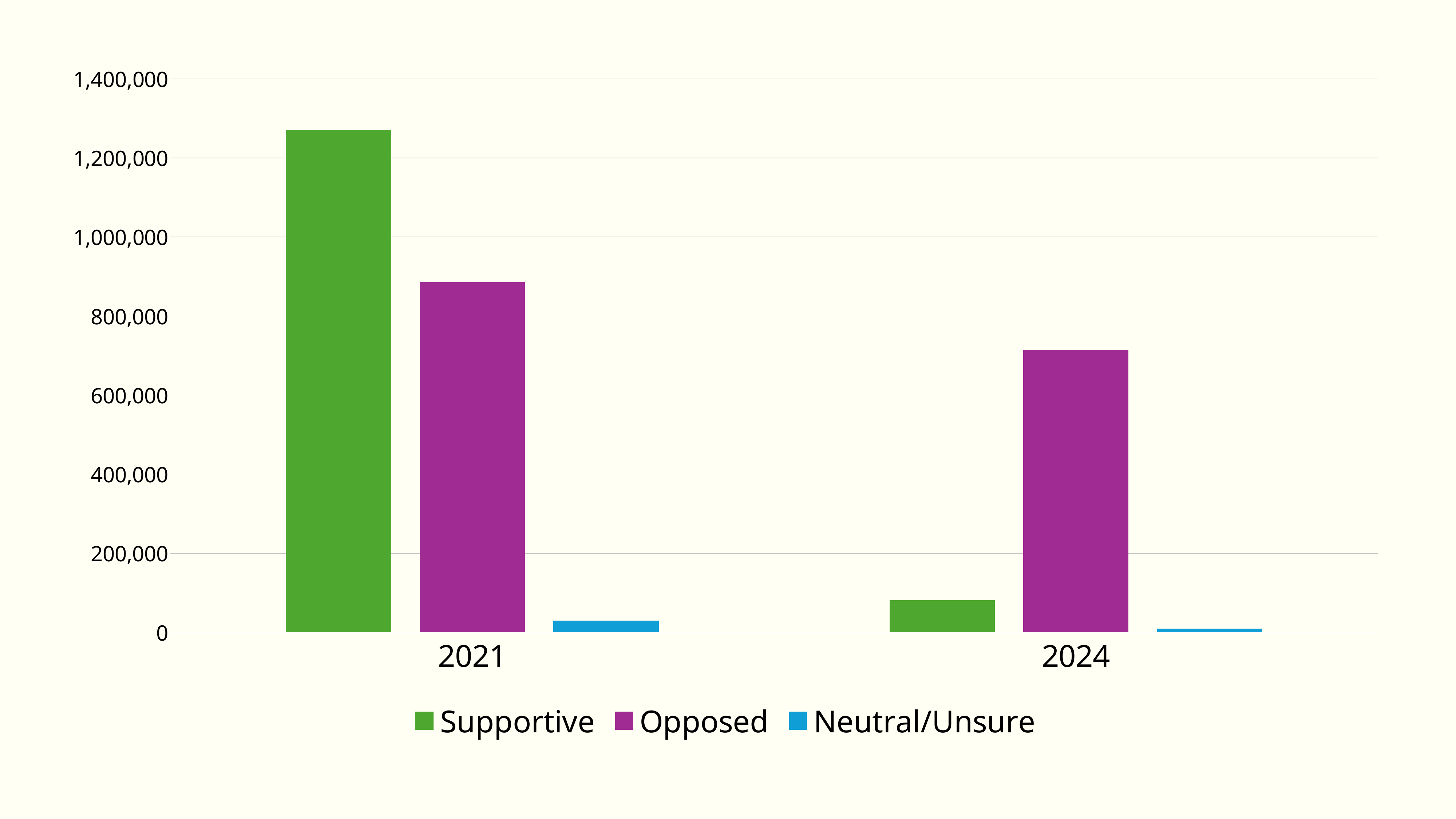
Is the value for Opposed in 2024 greater or less than 800,000? less What colour represents the Neutral/Unsure series? blue Which series has the lowest value in 2024? Neutral/Unsure Does the Supportive series rise or fall from 2021 to 2024? fall Which series has the highest value in 2024? Opposed How many series does the legend list? 3 Which series has the highest value in 2021? Supportive What kind of chart is shown on the slide? bar chart Is the value for Supportive in 2021 greater or less than 1,200,000? greater How many categories are shown on the x axis? 2 Which is larger, Opposed in 2021 or Opposed in 2024? Opposed in 2021 Is the value for Supportive in 2024 greater or less than 200,000? less